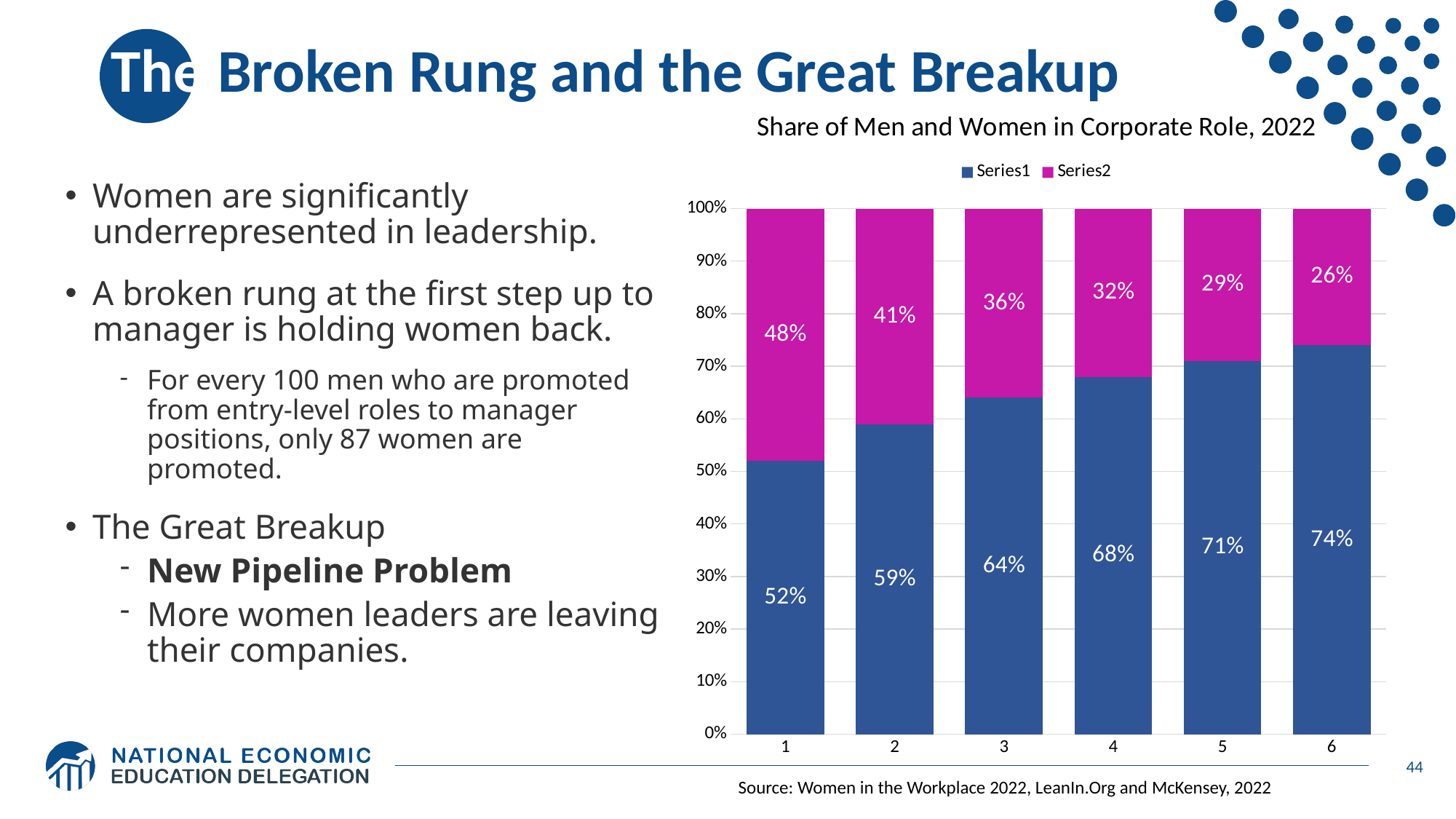
How many series does the legend list? 2 Which category has the lowest Series1 value? 1 What is the Series2 value for category 4? 32% What kind of chart is shown on the slide? Stacked bar chart How many categories are shown on the x axis? 6 What is the Series1 value for category 1? 52% What is the difference between the Series1 values for category 6 and category 1? 22% What is the Series1 value for category 6? 74% What is the title of the chart? Share of Men and Women in Corporate Role, 2022 Do the Series1 values rise or fall from category 1 to category 6? Rise Which category has the highest Series2 value? 1 Which is larger: the Series2 value for category 2 or the Series2 value for category 5? Series2 value for category 2